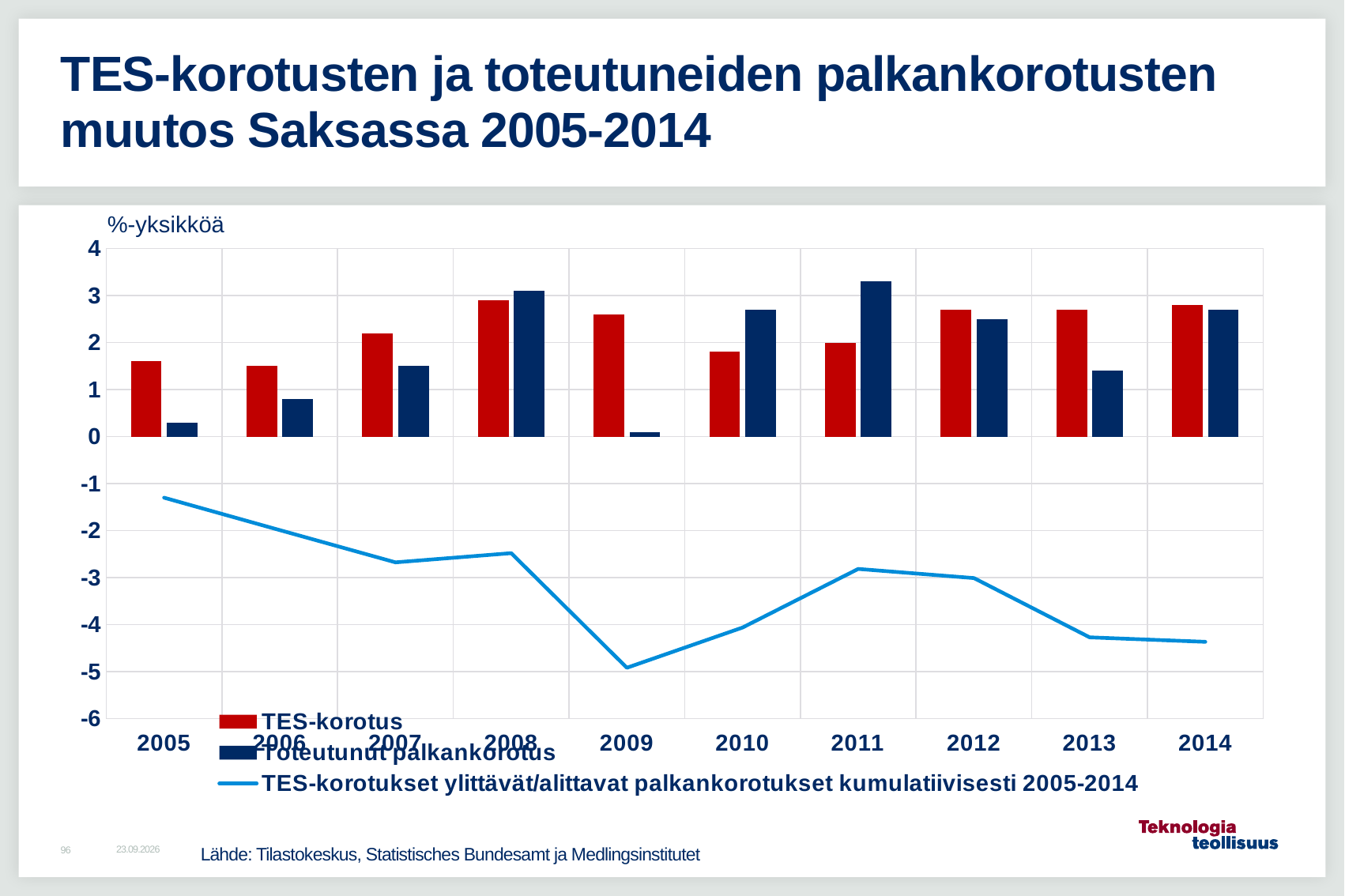
How many years are shown on the x axis of the chart? 10 Is the value of the cumulative line for 2009 greater or less than -4? less In which year is the line 'TES-korotukset ylittävät/alittavat palkankorotukset kumulatiivisesti 2005-2014' at its highest point? 2005 What kind of chart is shown on the slide? Combined bar and line chart In 2010, which is larger: TES-korotus or Toteutunut palkankorotus? Toteutunut palkankorotus In 2013, which is larger: TES-korotus or Toteutunut palkankorotus? TES-korotus Is the Toteutunut palkankorotus value for 2005 greater or less than 1? less In which year does the line 'TES-korotukset ylittävät/alittavat palkankorotukset kumulatiivisesti 2005-2014' reach its lowest point? 2009 In which year is the Toteutunut palkankorotus bar lowest? 2009 Is the TES-korotus value for 2008 greater or less than 2? greater How many series does the chart legend list? 3